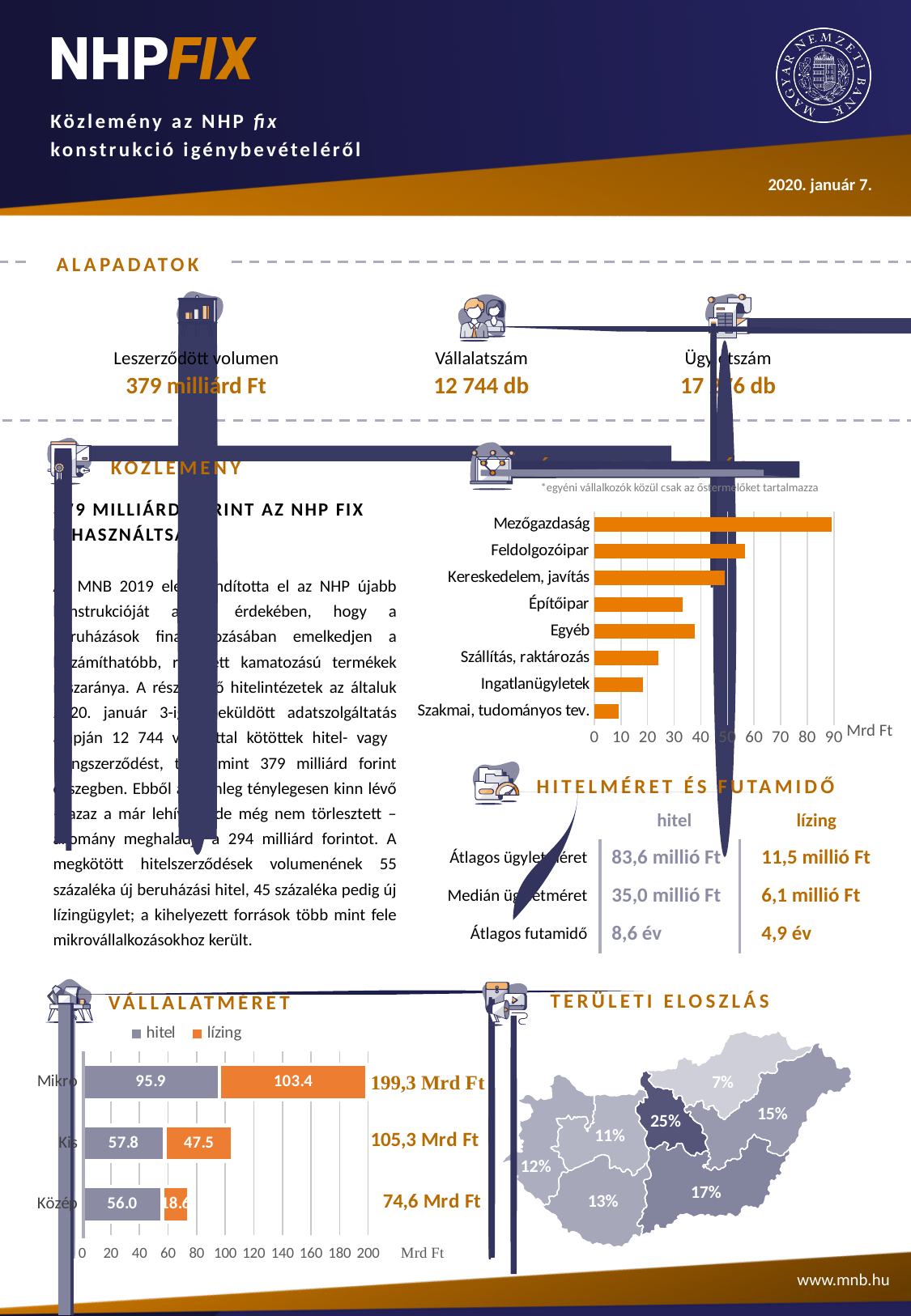
In the Vállalatméret chart, what is the hitel value for Mikro? 95.9 In the Vállalatméret chart, what is the lízing value for Kis? 47.5 How many sectors are shown in the sector bar chart in the upper right? 8 What kind of chart is the Vállalatméret chart? stacked bar chart In the sector bar chart in the upper right, which sector has the lowest value? Szakmai, tudományos tev. In the sector bar chart in the upper right (above Hitelméret és futamidő), which sector has the highest value? Mezőgazdaság In the sector bar chart in the upper right, is the value for Építőipar greater or less than 40? less In the Vállalatméret chart, which company size category has the highest total? Mikro How many series does the legend of the Vállalatméret chart list? 2 In the Vállalatméret chart, which is larger for Mikro: hitel or lízing? lízing In the Vállalatméret chart, what is the total shown for the Közép bar? 74,6 Mrd Ft In the Vállalatméret chart, what is the difference between the hitel and lízing values for Közép? 37.4